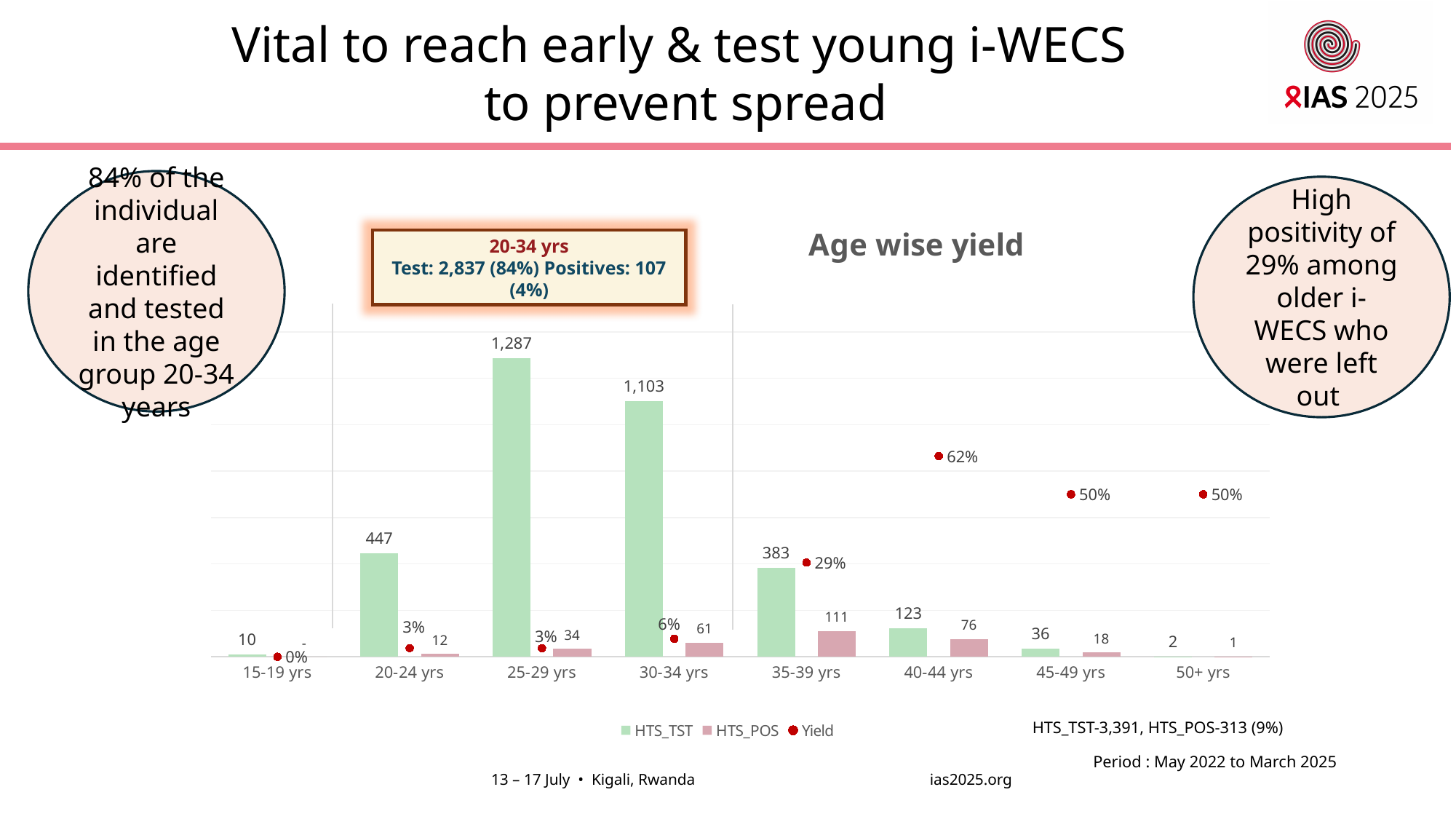
How many series does the legend list? 3 What kind of chart is used to show HTS_TST and HTS_POS? Bar chart Which age group has the highest HTS_TST value? 25-29 yrs What is the Yield for the 40-44 yrs age group? 62% What is the HTS_POS value for the 35-39 yrs age group? 111 What is the difference between the HTS_TST values for 25-29 yrs and 30-34 yrs? 184 How many age groups are shown on the x axis? 8 What is the HTS_TST value for the 25-29 yrs age group? 1,287 What is the title of the chart? Age wise yield Which age group has the highest Yield? 40-44 yrs Which is larger, the HTS_POS value for 30-34 yrs or for 40-44 yrs? 40-44 yrs Which age group has the lowest HTS_TST value? 50+ yrs